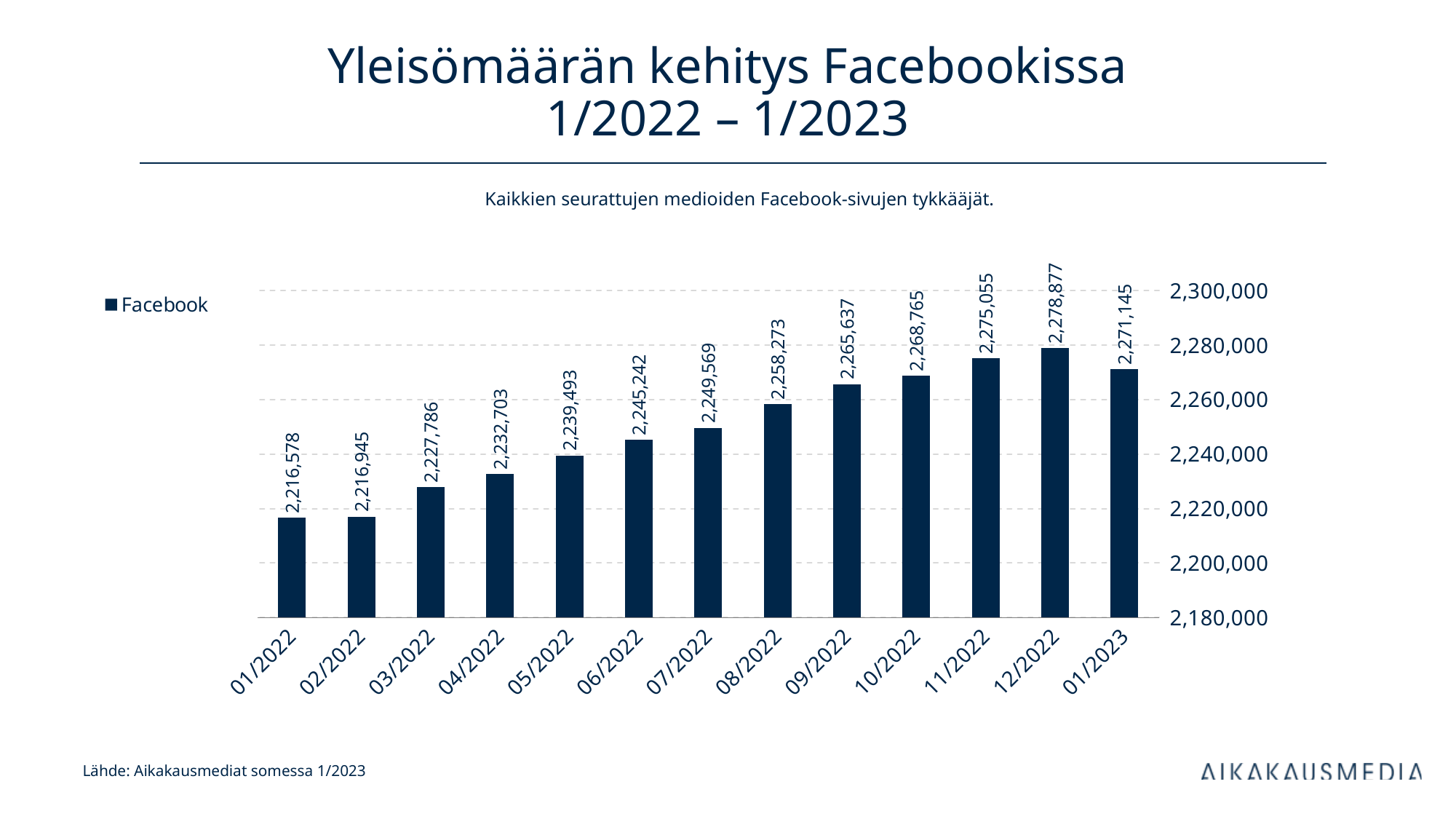
Which is larger, the value for 12/2022 or the value for 01/2023? 12/2022 Is the value for 08/2022 greater or less than 2,260,000? less What is the difference between the values for 12/2022 and 01/2022? 62,299 How many months are shown on the x axis? 13 Which month has the highest value? 12/2022 Which month has the lowest value? 01/2022 What kind of chart is shown on the slide? bar chart What is the difference between the values for 03/2022 and 02/2022? 10,841 What is the value for 01/2022? 2,216,578 How many series does the legend list? 1 What is the value for 07/2022? 2,249,569 What is the value for 12/2022? 2,278,877